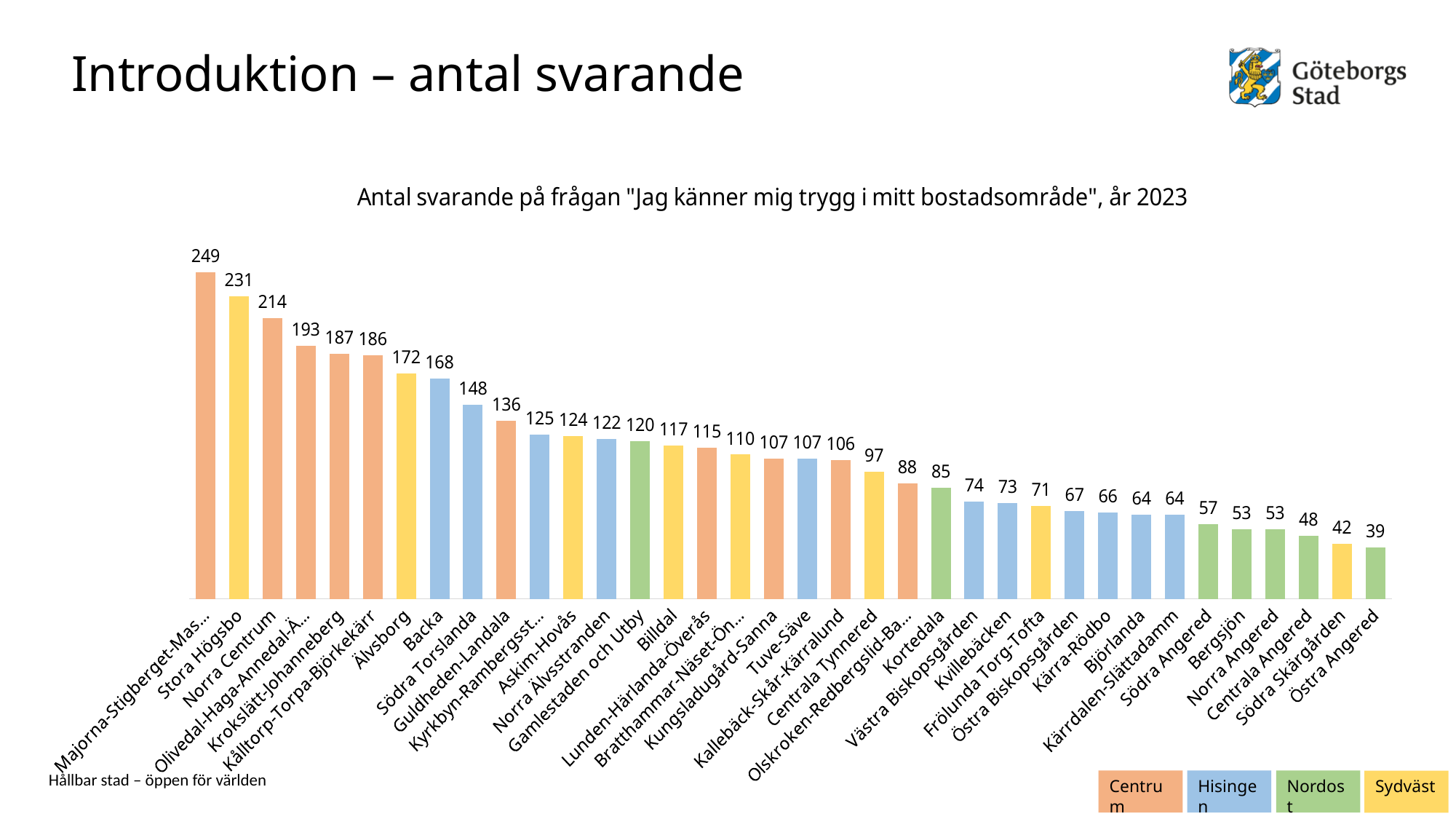
What is the value for Kortedala? 85 How many entries does the legend list? 4 What is the difference between the values for Södra Torslanda and Guldheden-Landala? 12 Which has a larger value, Älvsborg or Billdal? Älvsborg Do the values rise or fall from left to right along the x axis? Fall Which area has the highest number of respondents? Majorna-Stigberget-Mas... How many respondents are shown for Backa? 168 What is the difference between the values for Stora Högsbo and Norra Centrum? 17 Which area has the lowest number of respondents? Östra Angered How many areas (bars) are shown in the chart? 36 What is the value for Frölunda Torg-Tofta? 71 What type of chart is shown on the slide? Bar chart